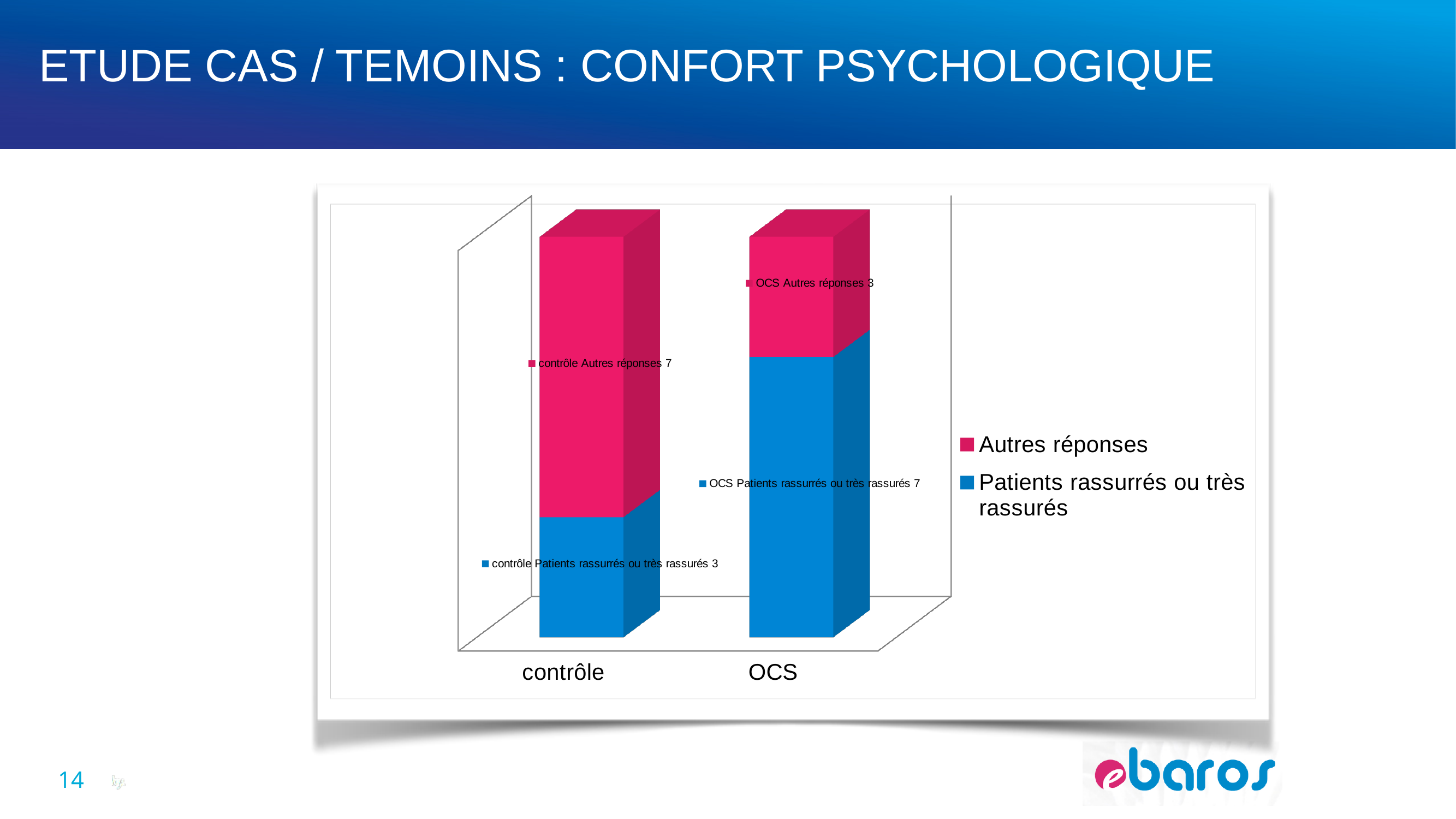
What is the total of the stacked bar for the contrôle group? 10 What is the difference between the 'Autres réponses' values for contrôle and OCS? 4 What is the value for 'Autres réponses' in the contrôle group? 7 How many series does the legend list? 2 Which group has the higher value for 'Patients rassurrés ou très rassurés', contrôle or OCS? OCS Which group has the lower value for 'Autres réponses'? OCS What is the value for 'Autres réponses' in the OCS group? 3 What kind of chart is shown on the slide? Stacked bar chart What is the value for 'Patients rassurrés ou très rassurés' in the contrôle group? 3 How many groups (categories) are shown on the x axis? 2 What is the total of the stacked bar for the OCS group? 10 What is the value for 'Patients rassurrés ou très rassurés' in the OCS group? 7